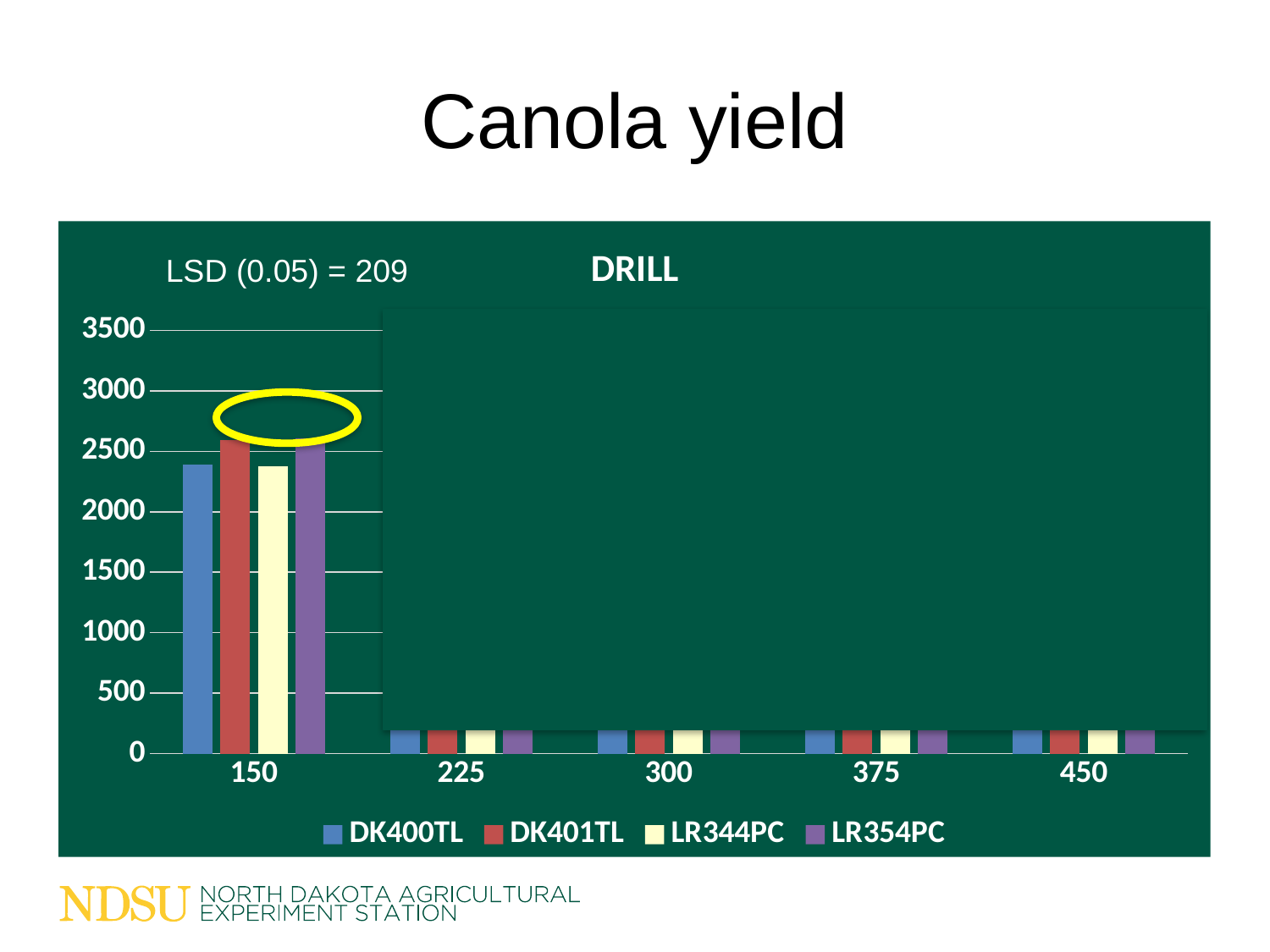
At 150, which is larger: DK401TL or DK400TL? DK401TL Is the value for DK400TL at 150 greater or less than 2000? greater Is the value for LR354PC at 150 greater or less than 2000? greater How many categories are shown on the x axis? 5 Is the value for DK401TL at 150 greater or less than 3000? less At 150, which is larger: DK401TL or LR344PC? DK401TL What is the title of the chart? DRILL What LSD value is printed on the chart? LSD (0.05) = 209 What kind of chart is shown on the slide? bar chart How many series does the legend list? 4